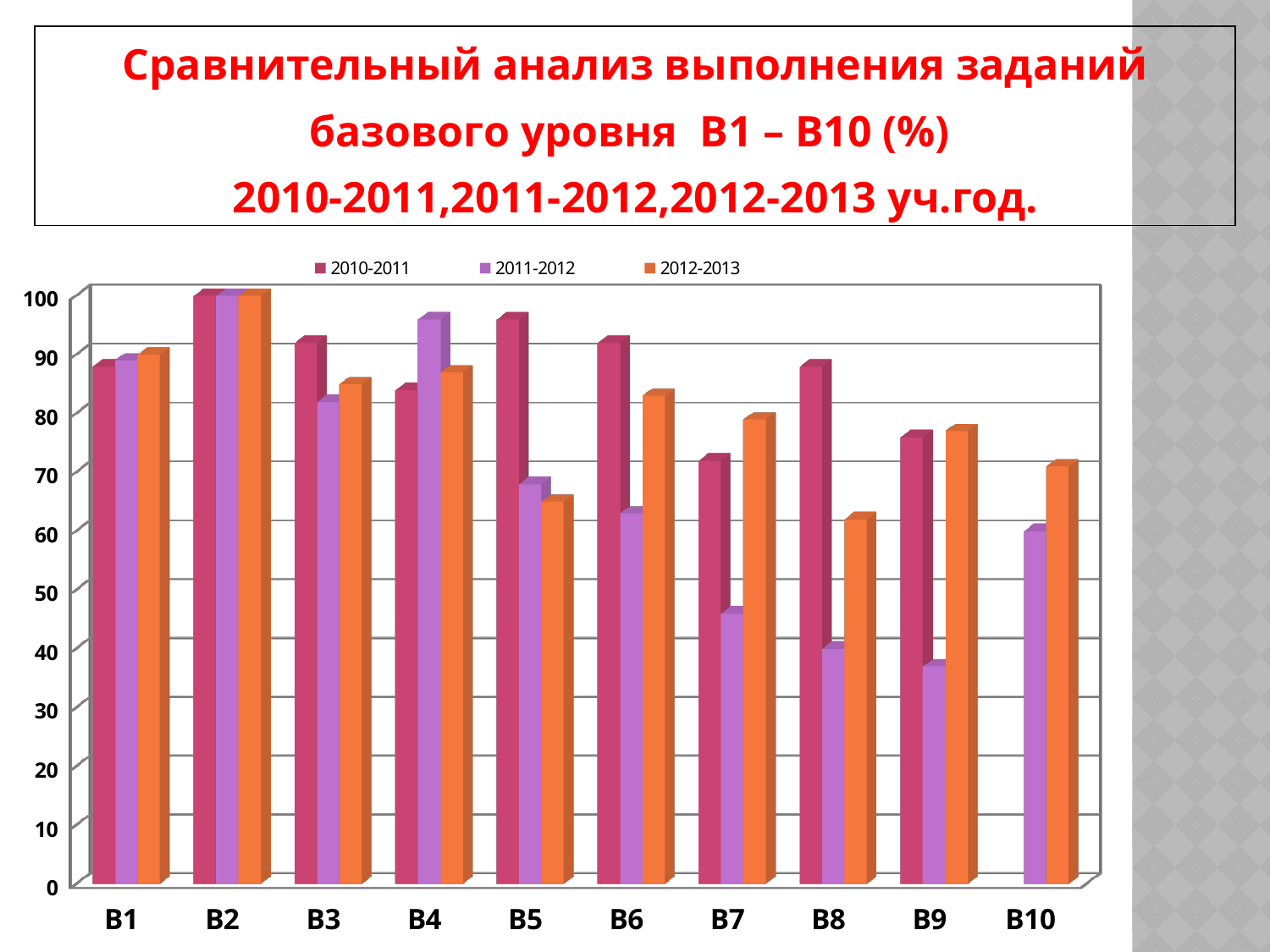
Which series is shown in orange? 2012-2013 For B8, which series has the larger value: 2010-2011 or 2011-2012? 2010-2011 How many categories are shown on the x axis? 10 For B4, which series has the larger value: 2010-2011 or 2011-2012? 2011-2012 Is the value for B6 in the 2012-2013 series greater or less than 70? greater How many series does the legend list? 3 What is the value for B2 in the 2010-2011 series? 100 Is the value for B8 in the 2011-2012 series greater or less than 50? less Do the values of the 2011-2012 series rise or fall from B5 to B9? fall What kind of chart is shown on the slide? bar chart Which category has the highest value in the 2011-2012 series? B2 Is the value for B7 in the 2011-2012 series greater or less than 50? less